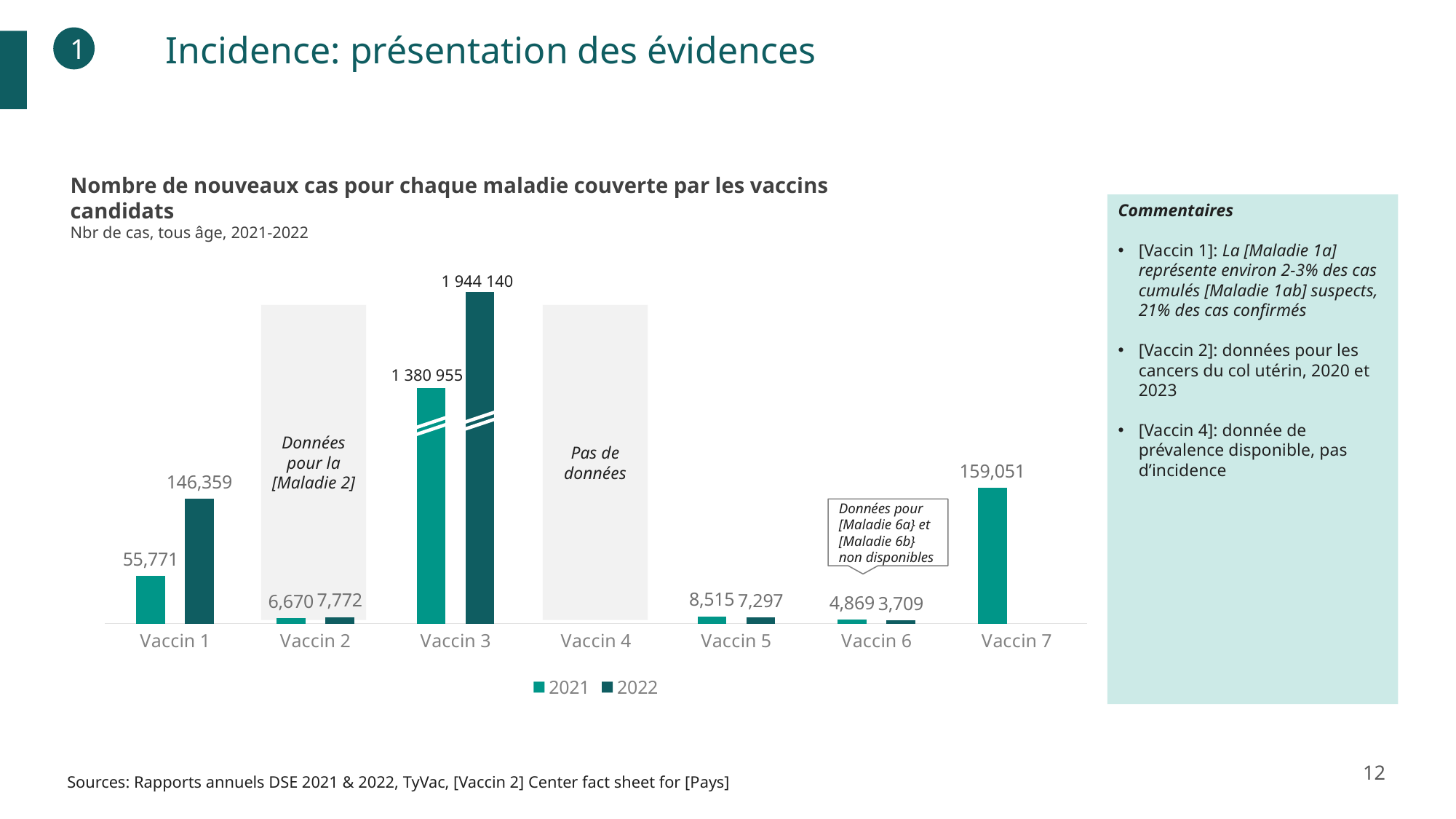
How many vaccine categories are shown on the x axis? 7 For Vaccin 6, which year has the larger value, 2021 or 2022? 2021 How many series does the legend list? 2 What is the difference between the 2022 and 2021 values for Vaccin 1? 90,588 What is the value for Vaccin 1 in 2021? 55,771 What is the difference between the 2021 and 2022 values for Vaccin 5? 1,218 What is the value for Vaccin 1 in 2022? 146,359 Which vaccine has the highest value in 2022? Vaccin 3 What kind of chart is shown on the slide? Bar chart Which vaccine has the lowest value in 2022 among those with a plotted 2022 bar? Vaccin 6 What is the value for Vaccin 3 in 2022? 1 944 140